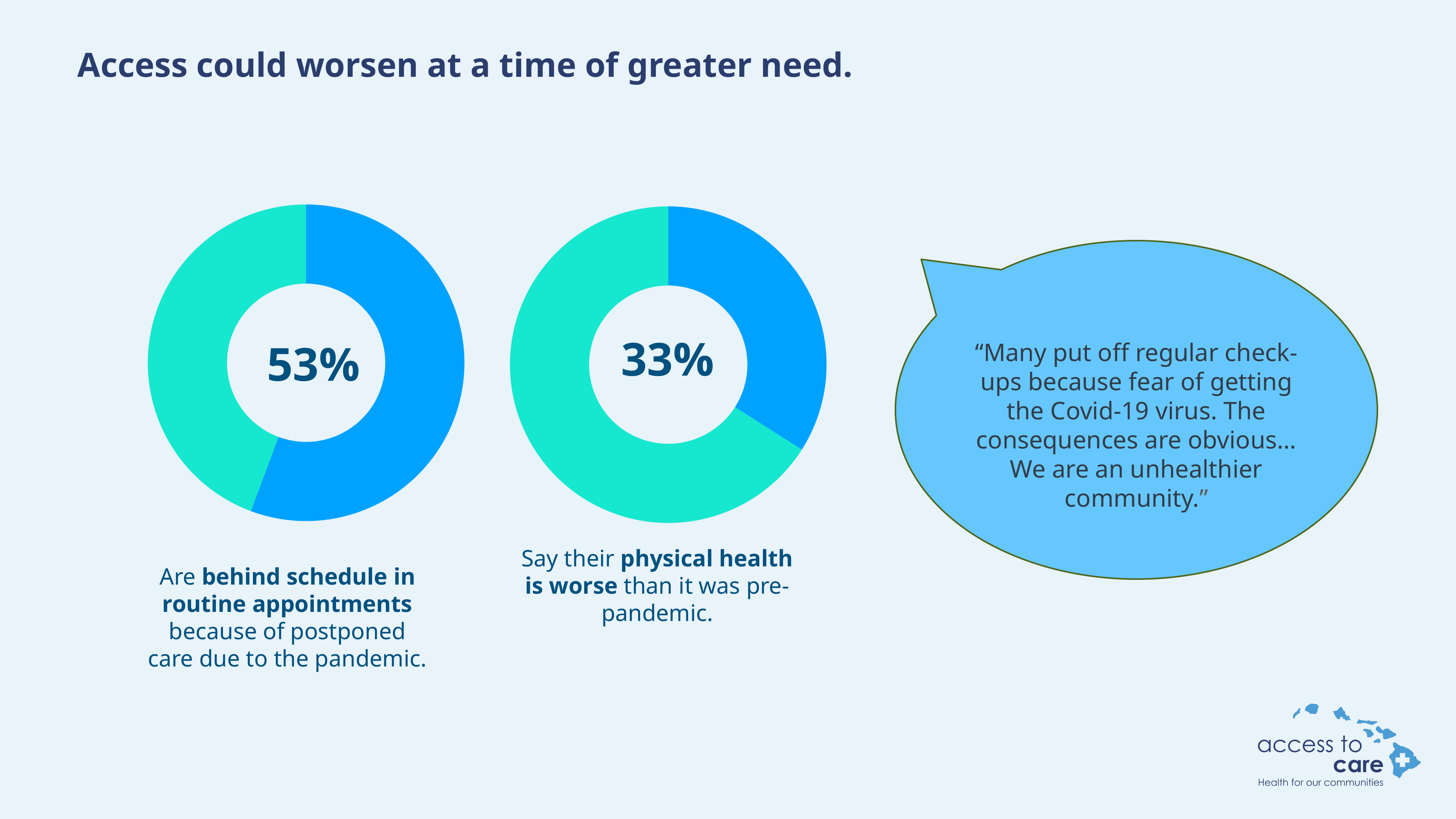
Is the value shown in the right donut chart (physical health is worse) greater or less than 50%? less What kind of chart is used to show the 53% and 33% figures on this slide? Donut (pie) chart Which is larger: the share behind schedule in routine appointments or the share saying their physical health is worse than pre-pandemic? Behind schedule in routine appointments What percentage of respondents say their physical health is worse than it was pre-pandemic, according to the right donut chart? 33% How many donut charts are shown on the slide? 2 What is the title of the slide containing the two donut charts? Access could worsen at a time of greater need. Which of the two donut charts shows the lowest percentage? The right chart (physical health is worse), 33% What is the difference in percentage points between the value in the left donut chart (behind schedule in routine appointments) and the value in the right donut chart (physical health is worse)? 20 percentage points Is the value shown in the left donut chart (behind schedule in routine appointments) greater or less than 50%? greater What colour is the segment representing the 53% value in the left donut chart? Blue What percentage of respondents are behind schedule in routine appointments because of postponed care due to the pandemic, according to the left donut chart? 53%